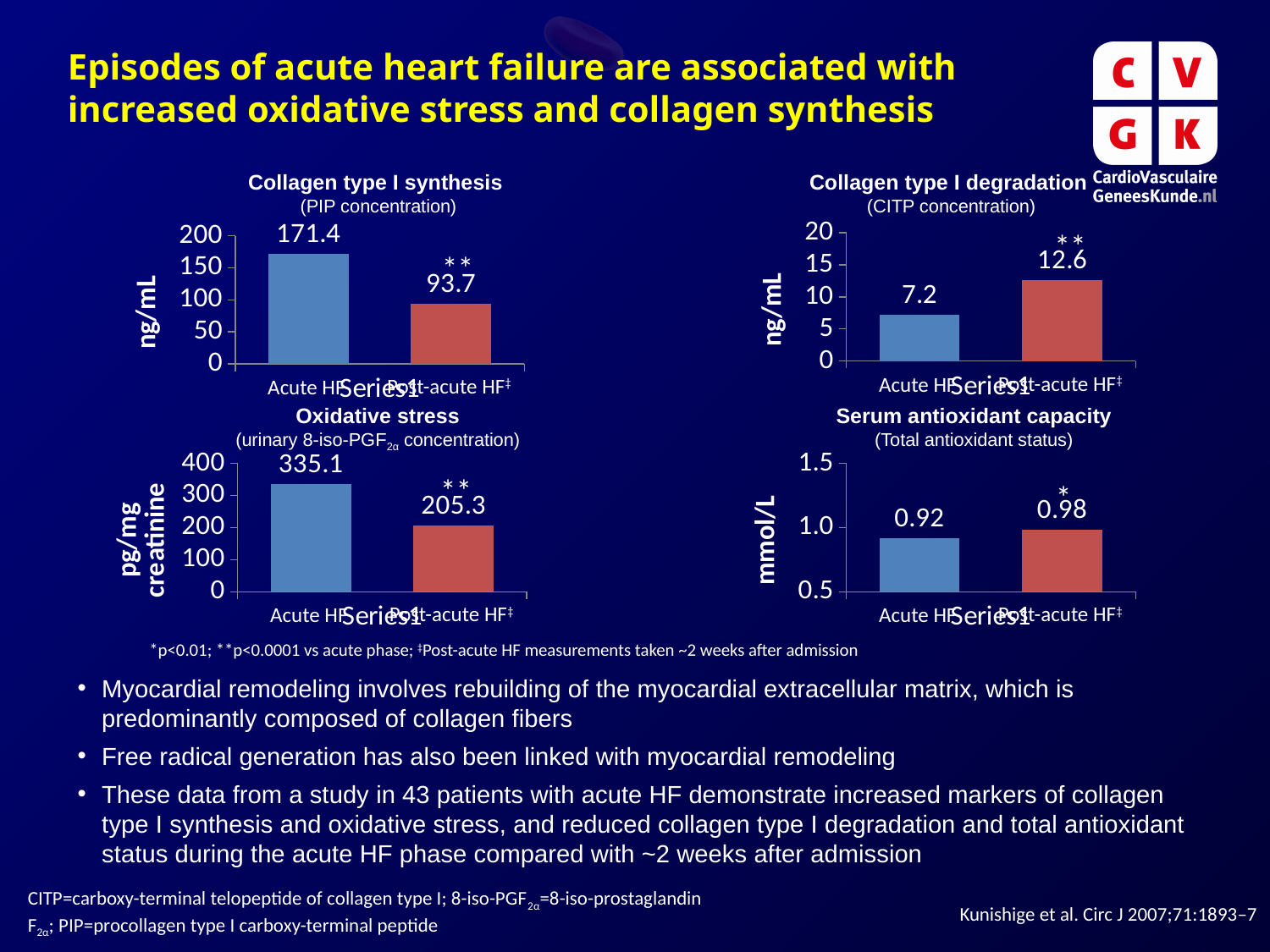
In the Collagen type I synthesis chart, what is the value for Post-acute HF? 93.7 In the Serum antioxidant capacity chart, what is the value for Acute HF? 0.92 In the Collagen type I degradation chart, what is the CITP concentration for Post-acute HF? 12.6 In the Collagen type I synthesis chart, what is the difference between the Acute HF and Post-acute HF values? 77.7 How many categories are shown in the Oxidative stress chart? 2 In the Collagen type I degradation chart, which category has the higher value, Acute HF or Post-acute HF? Post-acute HF What type of chart is the Serum antioxidant capacity chart? Bar chart What unit is shown on the y-axis of the Serum antioxidant capacity chart? mmol/L In the Oxidative stress chart, what is the value for Acute HF? 335.1 In the Collagen type I synthesis chart, what is the PIP concentration for Acute HF? 171.4 In the Oxidative stress chart, which category has the lowest value? Post-acute HF In the Collagen type I degradation chart, what is the difference between the Post-acute HF and Acute HF values? 5.4